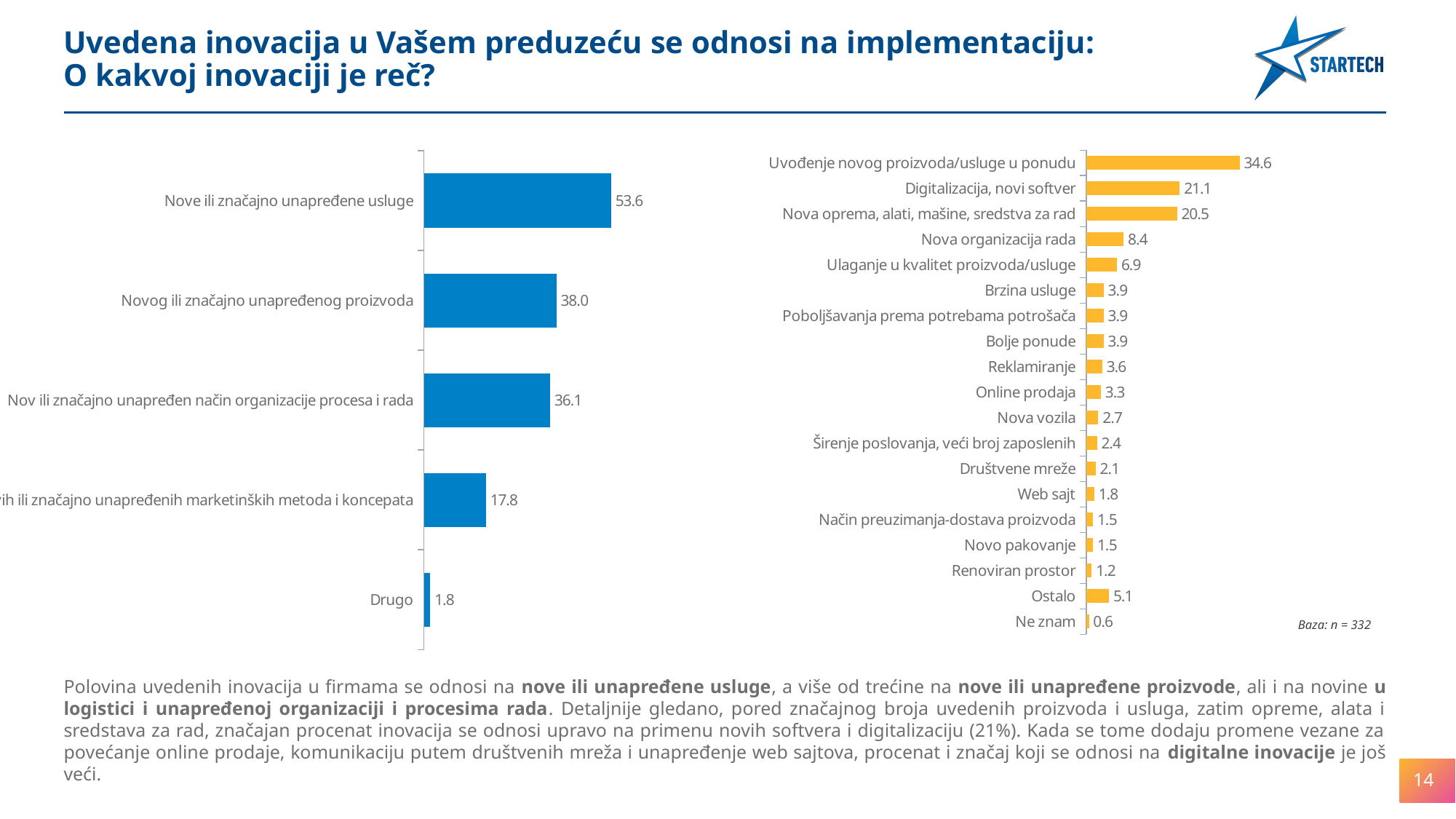
What kind of chart is the chart on the right side of the slide? Bar chart In the left chart, which category has the lowest value? Drugo In the right chart, which category has the lowest value? Ne znam In the right chart, what is the value for 'Digitalizacija, novi softver'? 21.1 In the right chart, how many categories are shown? 19 In the right chart, which category has the highest value? Uvođenje novog proizvoda/usluge u ponudu In the left chart, what is the value for 'Nove ili značajno unapređene usluge'? 53.6 In the right chart, what is the difference between 'Uvođenje novog proizvoda/usluge u ponudu' and 'Nova oprema, alati, mašine, sredstva za rad'? 14.1 In the right chart, which is larger: 'Nova organizacija rada' or 'Ulaganje u kvalitet proizvoda/usluge'? Nova organizacija rada In the left chart, what is the value for 'Novog ili značajno unapređenog proizvoda'? 38.0 In the left chart, what is the difference between 'Novog ili značajno unapređenog proizvoda' and 'Nov ili značajno unapređen način organizacije procesa i rada'? 1.9 In the left chart, how many categories are shown? 5